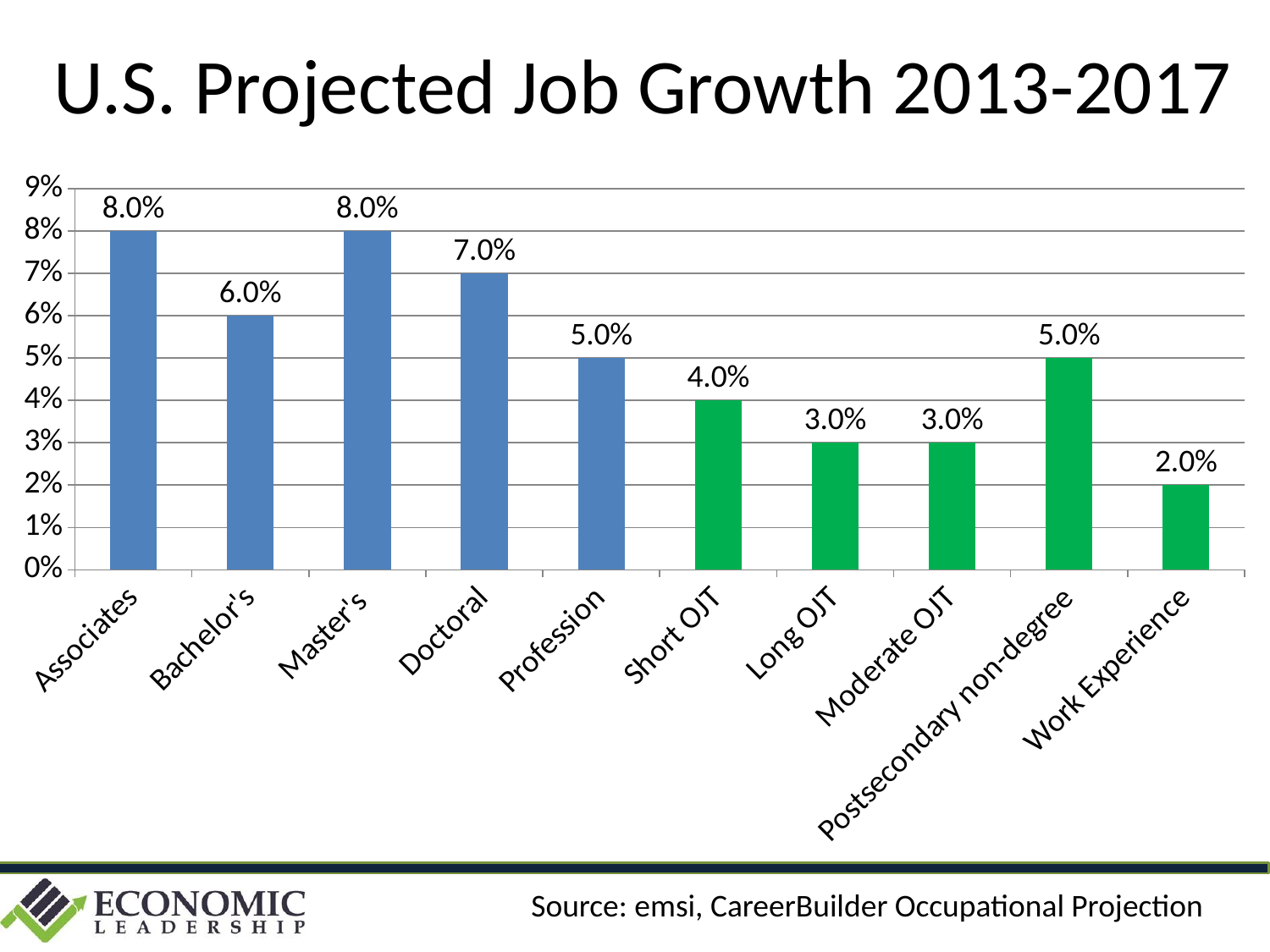
What colour are the bars for Short OJT, Long OJT, Moderate OJT, Postsecondary non-degree and Work Experience? green What kind of chart is shown on the slide? bar chart What is the projected job growth for Short OJT? 4.0% Which category has the lowest projected job growth? Work Experience Which has higher projected job growth, Profession or Moderate OJT? Profession Which two categories share the highest projected job growth of 8.0%? Associates and Master's How many categories are shown on the x axis? 10 Is the value for Master's greater or less than 7%? greater What is the difference between the projected job growth for Bachelor's and Long OJT? 3.0% What is the projected job growth for Doctoral? 7.0% What is the title of the chart? U.S. Projected Job Growth 2013-2017 What is the projected job growth for Postsecondary non-degree? 5.0%